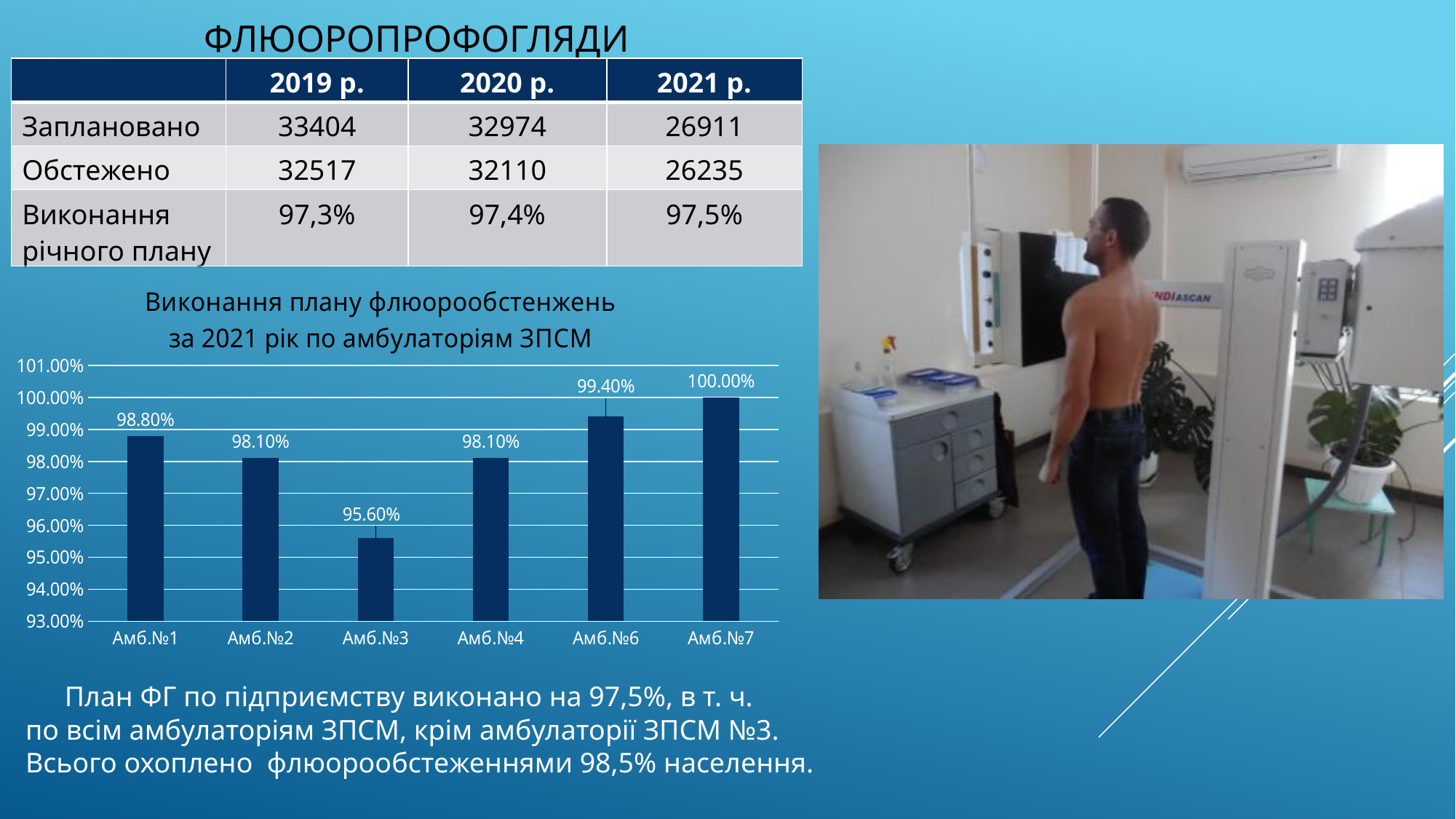
Which category has the highest value in the chart? Амб.№7 What is the difference between the values for Амб.№6 and Амб.№2? 1.30% Is the value for Амб.№3 greater or less than 96.00%? less What is the value for Амб.№1 in the chart? 98.80% How many categories are shown in the chart? 6 What is the difference between the values for Амб.№7 and Амб.№3? 4.40% What kind of chart is shown on the slide? bar chart Which is larger, the value for Амб.№1 or the value for Амб.№4? Амб.№1 What is the title of the chart? Виконання плану флюорообстенжень за 2021 рік по амбулаторіям ЗПСМ What is the value for Амб.№3 in the chart? 95.60% What is the value for Амб.№6 in the chart? 99.40% Which category has the lowest value in the chart? Амб.№3